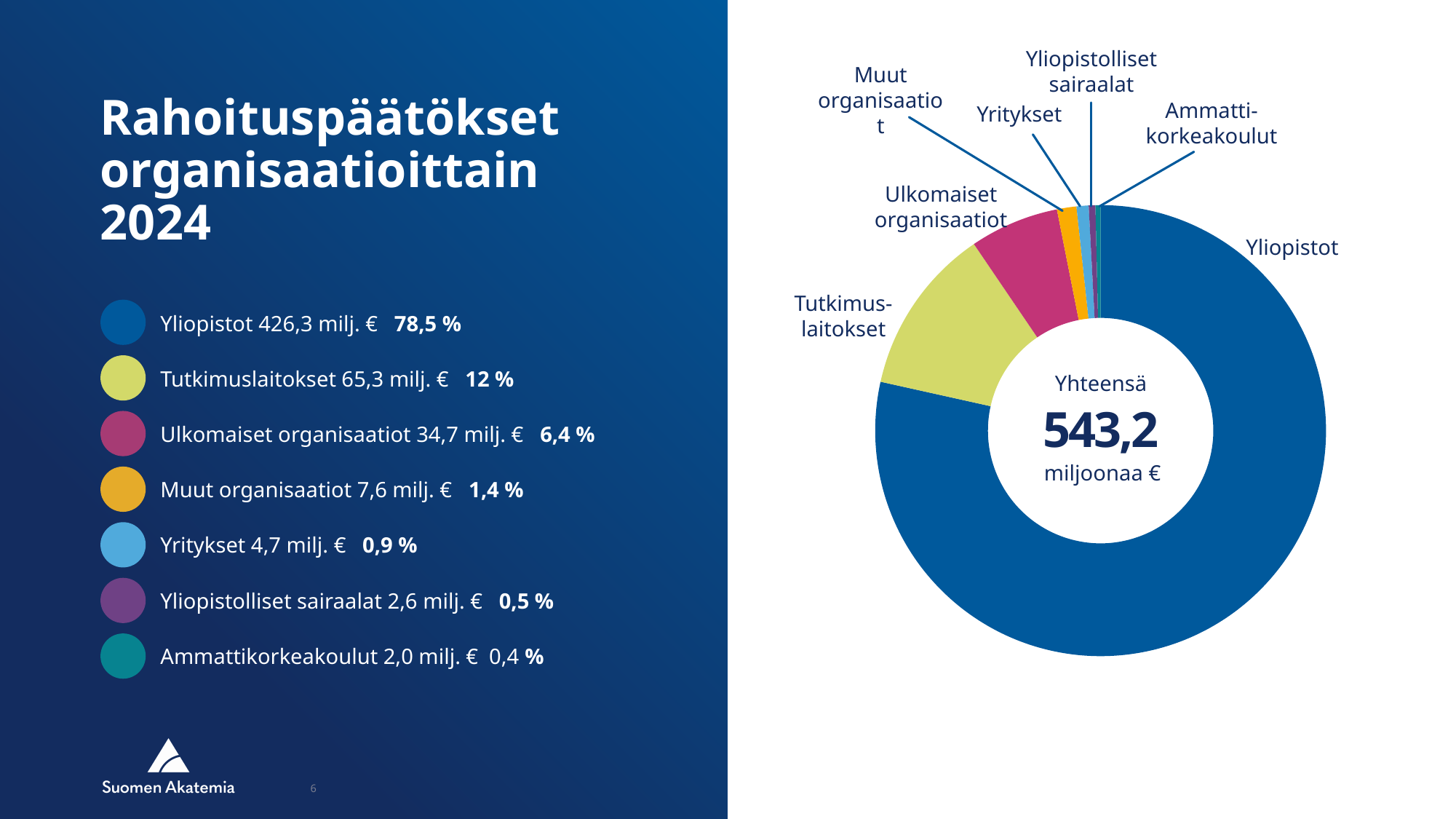
What kind of chart is shown on the slide? Pie chart (donut) What share of the pie does Yritykset have? 0,9 % How many categories does the pie chart have? 7 What is the funding amount for Yliopistot? 426,3 milj. € Which is larger, the funding for Muut organisaatiot or for Yritykset? Muut organisaatiot What colour is the Tutkimuslaitokset slice? Yellow-green What is the funding amount for Ulkomaiset organisaatiot? 34,7 milj. € What share of the pie does Tutkimuslaitokset have? 12 % What is the difference in funding between Yliopistot and Tutkimuslaitokset? 361,0 milj. € Which category has the largest slice of the pie? Yliopistot Which category has the smallest slice of the pie? Ammattikorkeakoulut What total amount is shown in the centre of the donut chart? 543,2 miljoonaa €